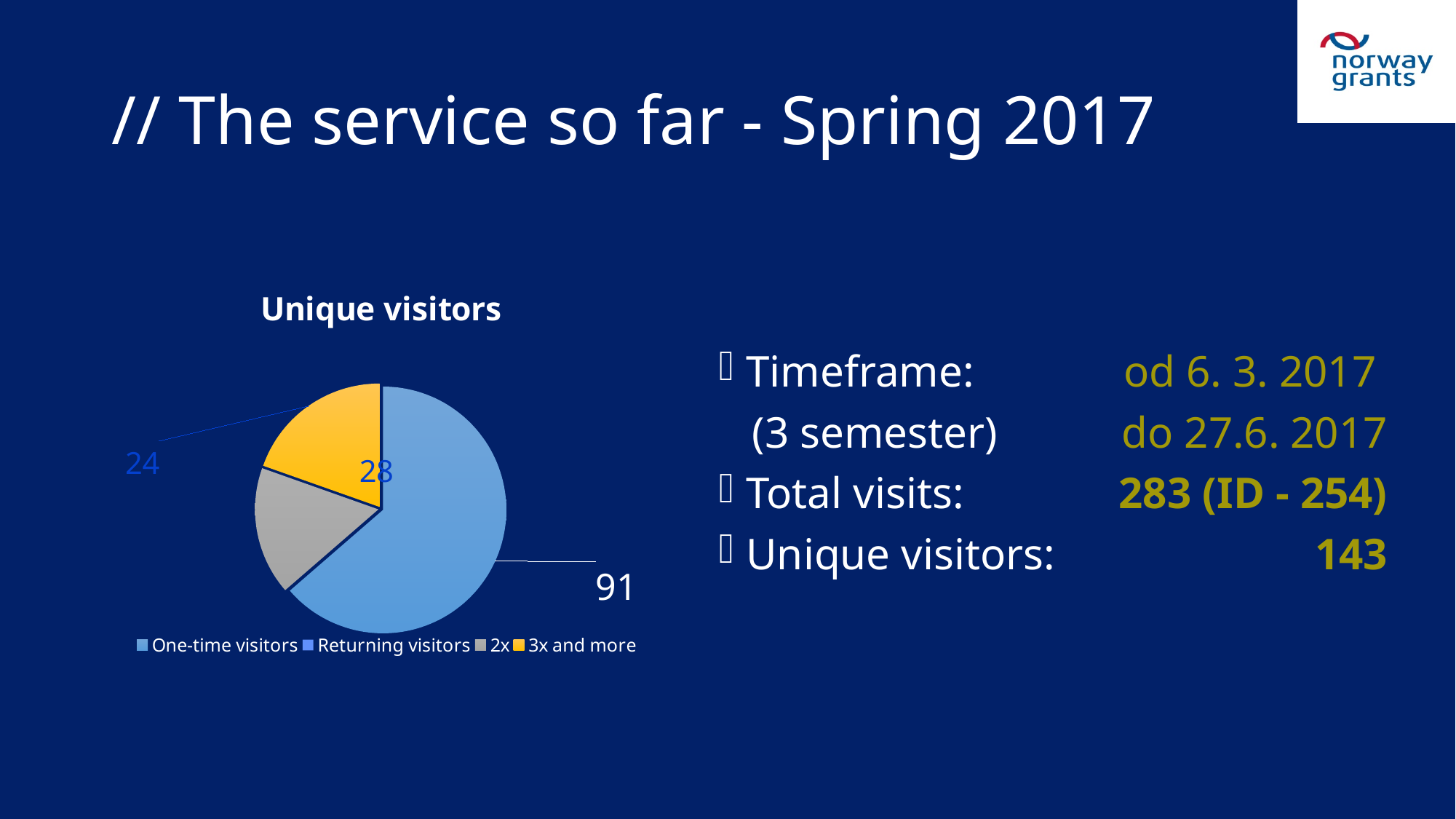
Which legend entry is shown in yellow? 3x and more What is the value for One-time visitors in the pie chart? 91 Which category has the largest slice in the pie chart? One-time visitors Which is larger in the pie chart: One-time visitors or 3x and more? One-time visitors What is the difference between the One-time visitors value and the 3x and more value? 63 What is the value for the 3x and more slice in the pie chart? 28 How many data labels are printed on the pie chart? 3 What is the sum of the three values labelled on the pie chart (91, 28 and 24)? 143 What is the title of the chart? Unique visitors How many entries does the chart legend list? 4 What kind of chart is shown on the slide? pie chart